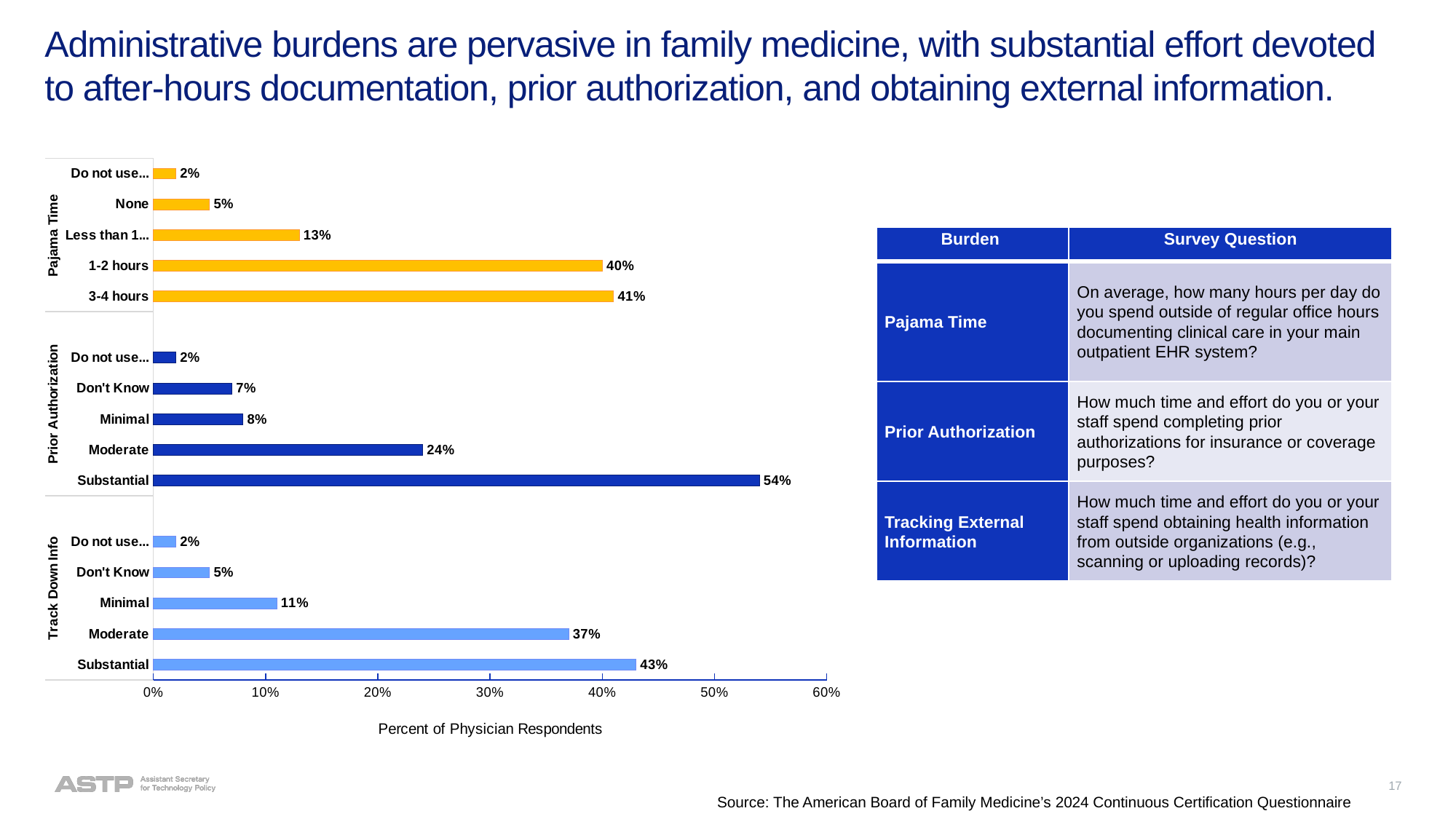
What is the difference between the Substantial value for Prior Authorization and the Substantial value for Track Down Info? 11 percentage points What percentage of respondents reported Substantial effort for Prior Authorization? 54% What percentage of physician respondents reported 3-4 hours of Pajama Time? 41% What percentage of respondents reported Minimal effort for Prior Authorization? 8% How many bars are plotted in the chart in total? 15 Is the value for Moderate under Track Down Info greater or less than 40%? less Which bar in the whole chart has the highest value? Substantial (Prior Authorization) Within the Pajama Time group, which category has the lowest value? Do not use... What is the label of the horizontal axis of the chart? Percent of Physician Respondents What percentage of respondents reported Moderate effort for Track Down Info? 37% What kind of chart is shown on the slide? bar chart Which is larger: the Moderate value for Prior Authorization or the Moderate value for Track Down Info? Moderate for Track Down Info